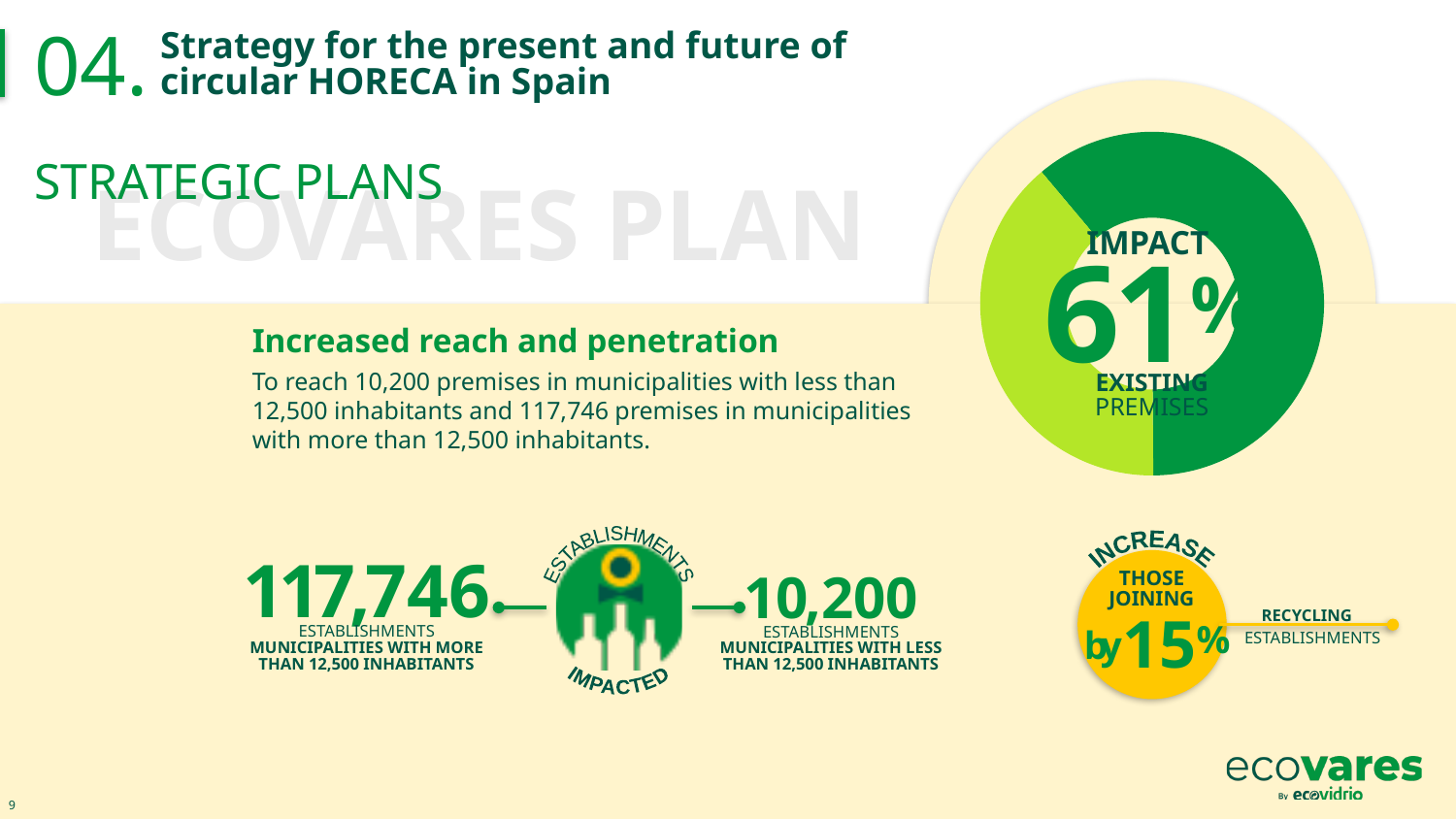
Which segment of the donut chart is larger, the dark green one or the light green one? Dark green What percentage is printed in the centre of the donut chart? 61% What word appears above the percentage in the centre of the donut chart? IMPACT What share of existing premises does the donut chart show as impacted? 61% What label appears below the percentage in the centre of the donut chart? EXISTING PREMISES What kind of chart is shown on the right side of the slide? Donut (pie) chart How many segments does the donut chart have? 2